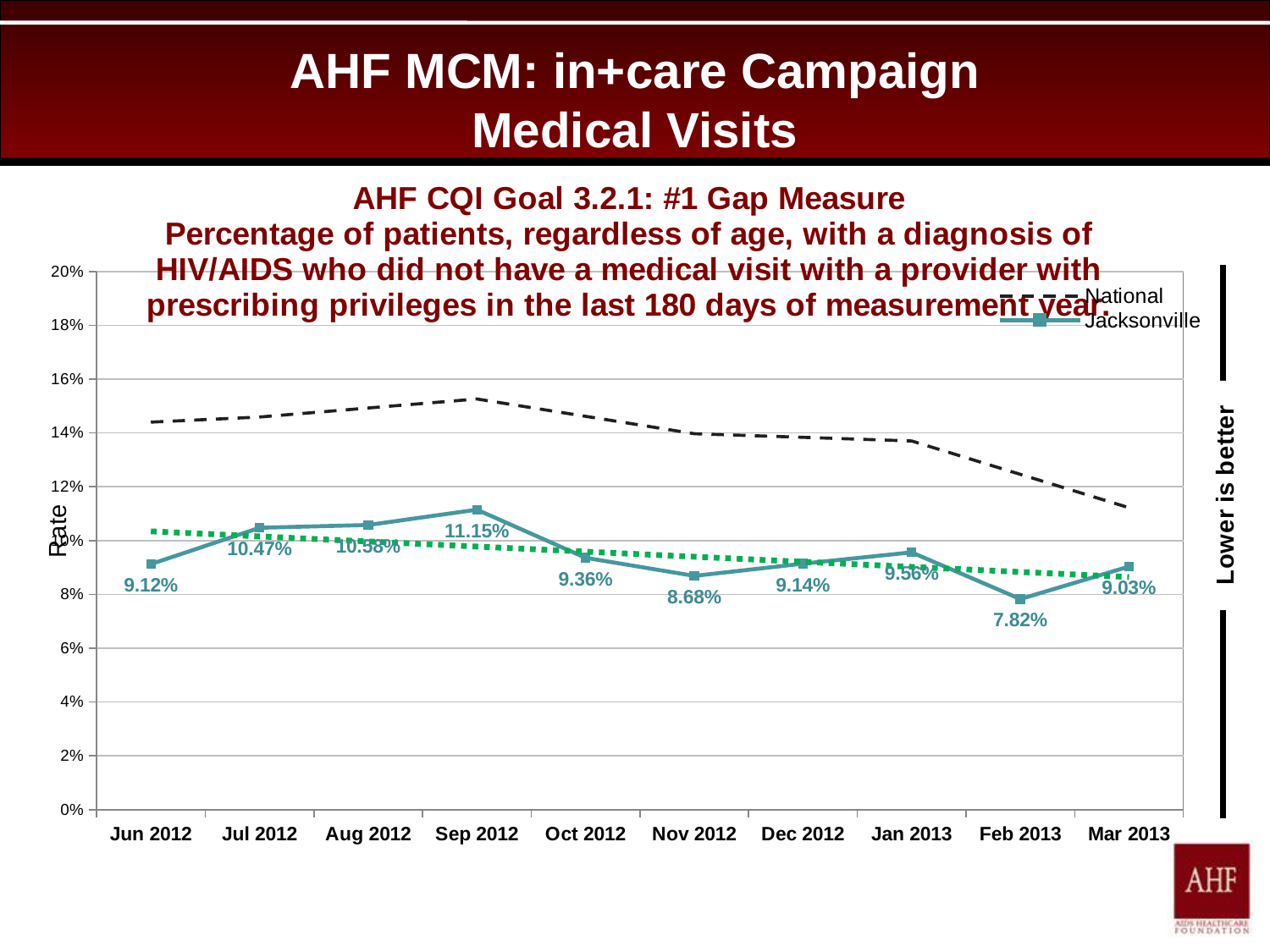
Is the National rate for Mar 2013 greater or less than 12%? less What is the Jacksonville rate for Sep 2012? 11.15% In which month is the Jacksonville rate highest? Sep 2012 Which is larger, the Jacksonville rate in Jul 2012 or in Nov 2012? Jul 2012 In which month is the Jacksonville rate lowest? Feb 2013 What is the difference between the Jacksonville rate in Sep 2012 and Feb 2013? 3.33% What is the Jacksonville rate for Feb 2013? 7.82% How many series does the legend list? 2 What is the Jacksonville rate for Jun 2012? 9.12% How many months are shown on the x axis? 10 What kind of chart is shown on the slide? Line chart Is the National rate for Sep 2012 greater or less than 14%? greater